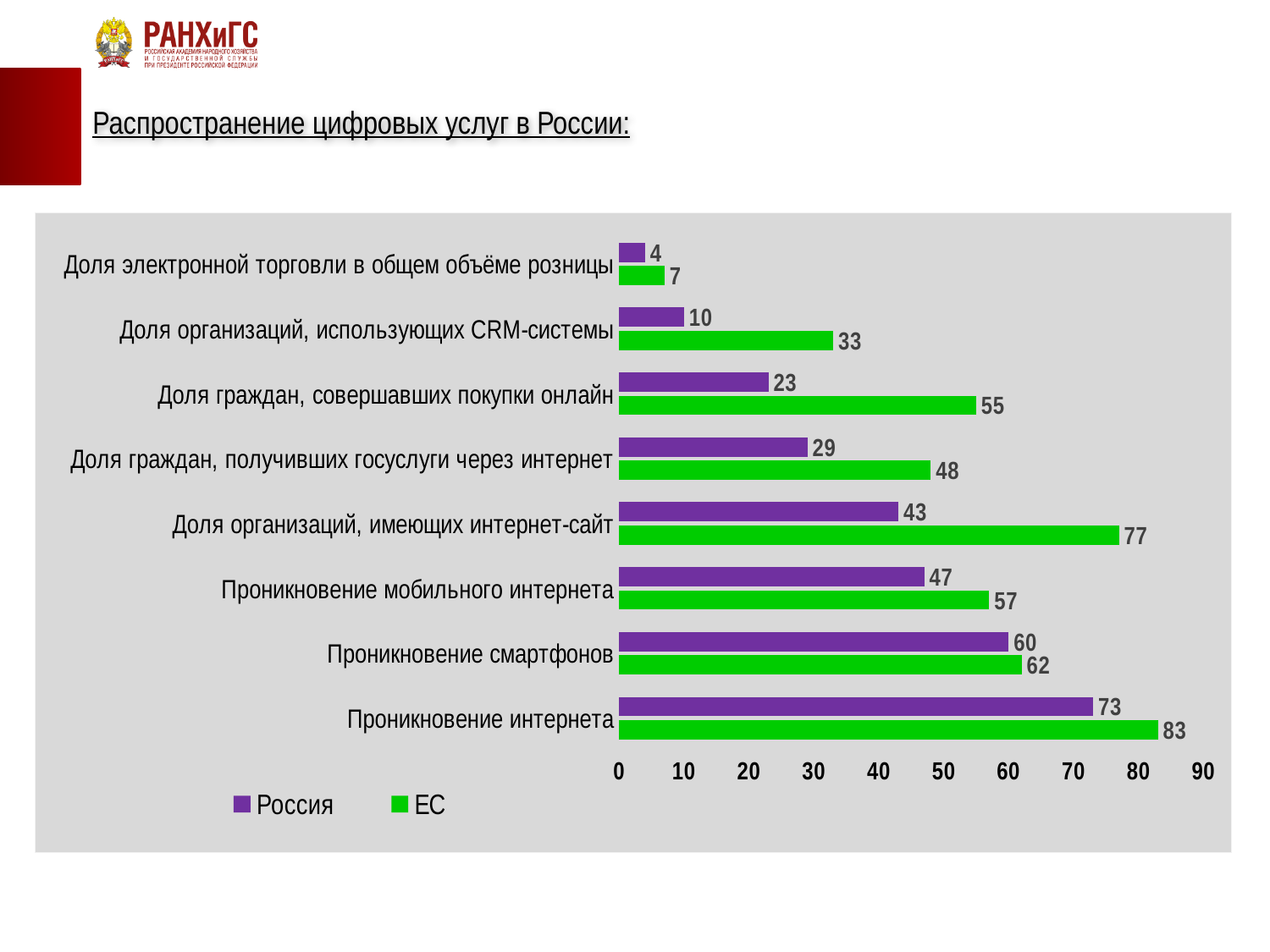
Which is larger for Доля граждан, совершавших покупки онлайн: the value for Россия or for ЕС? ЕС What kind of chart is shown on the slide? Bar chart What is the difference between the ЕС and Россия values for Проникновение смартфонов? 2 What is the difference between the ЕС and Россия values for Доля организаций, имеющих интернет-сайт? 34 Which category has the lowest value for Россия? Доля электронной торговли в общем объёме розницы What is the value for Россия for Доля граждан, получивших госуслуги через интернет? 29 What is the value for Россия for Проникновение интернета? 73 How many series does the legend list? 2 How many categories are shown on the chart? 8 What is the value for ЕС for Доля организаций, использующих CRM-системы? 33 Which colour represents the ЕС series in the chart? Green Which category has the highest value for ЕС? Проникновение интернета